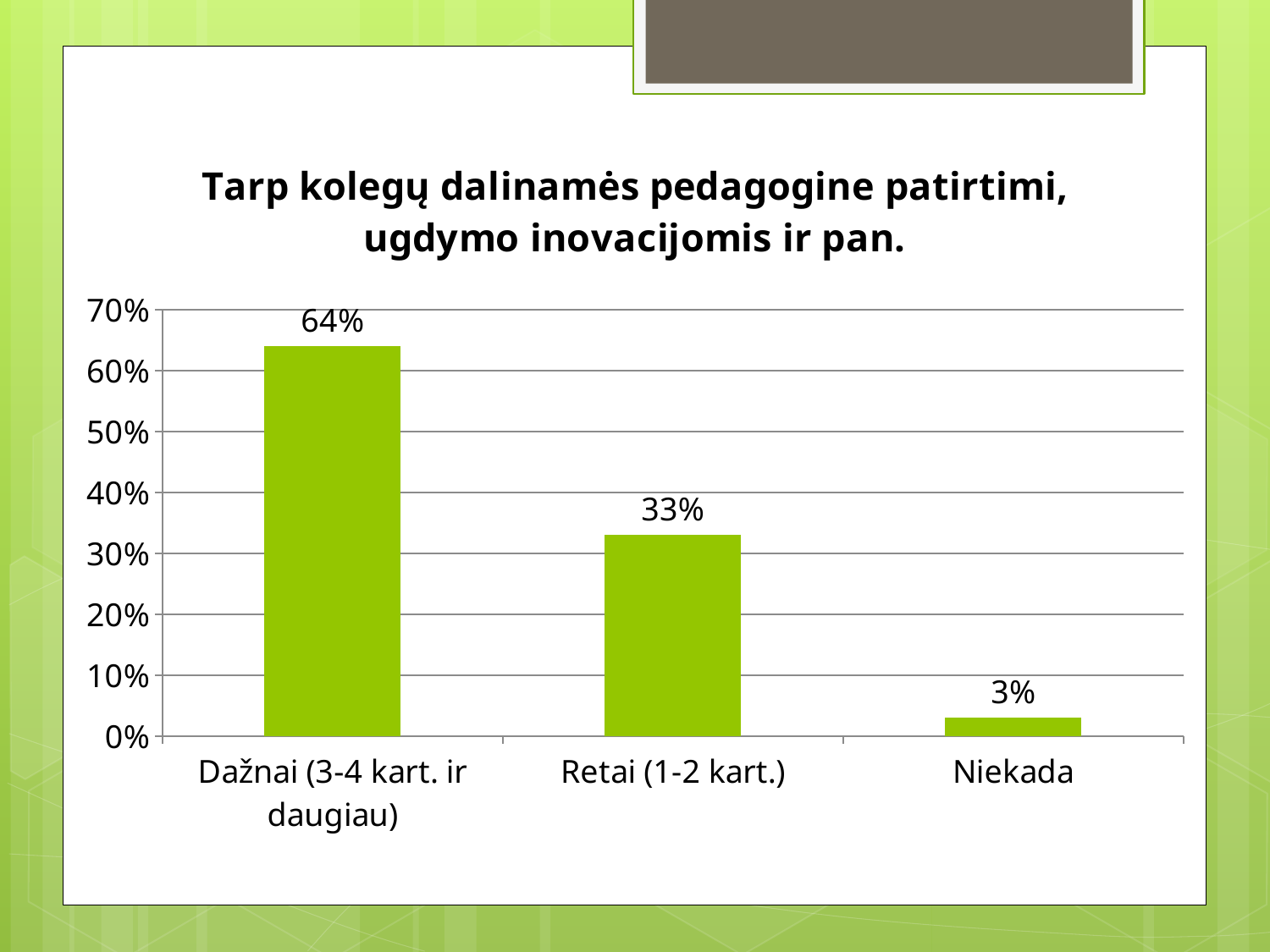
What is the difference between the values for "Dažnai (3-4 kart. ir daugiau)" and "Retai (1-2 kart.)"? 31% What is the value for "Retai (1-2 kart.)"? 33% What is the value for "Dažnai (3-4 kart. ir daugiau)"? 64% Which category has the highest value? Dažnai (3-4 kart. ir daugiau) Which is larger, the value for "Retai (1-2 kart.)" or the value for "Niekada"? Retai (1-2 kart.) What is the value for "Niekada"? 3% What is the difference between the values for "Retai (1-2 kart.)" and "Niekada"? 30% Which category has the lowest value? Niekada Is the value for "Retai (1-2 kart.)" greater or less than 40%? less What is the title of the chart? Tarp kolegų dalinamės pedagogine patirtimi, ugdymo inovacijomis ir pan. What kind of chart is shown on the slide? bar chart How many categories are shown on the x axis? 3